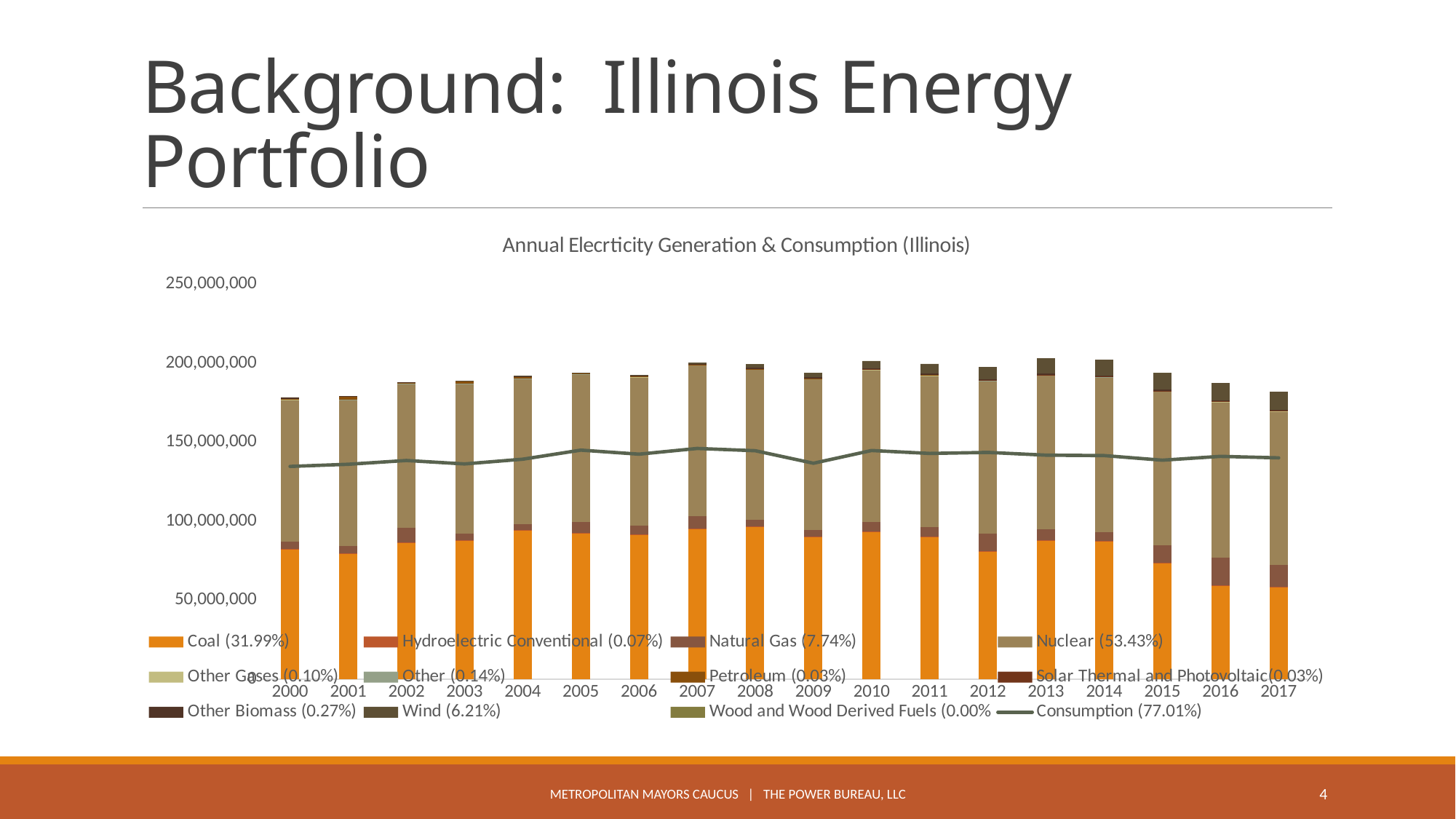
What is the title of the chart? Annual Elecrticity Generation & Consumption (Illinois) How many series does the chart's legend list? 12 Does the Coal segment rise or fall from 2000 to 2017? fall What kind of chart is shown on the slide? Stacked bar chart with a line Is the Consumption line value for 2010 greater or less than 150,000,000? less Which year has the larger Coal value, 2000 or 2017? 2000 Is the Coal value for 2017 greater or less than 50,000,000? greater Is the Coal value for 2000 greater or less than 100,000,000? less What percentage is shown next to Nuclear in the legend? 53.43% How many years are shown along the x axis of the chart? 18